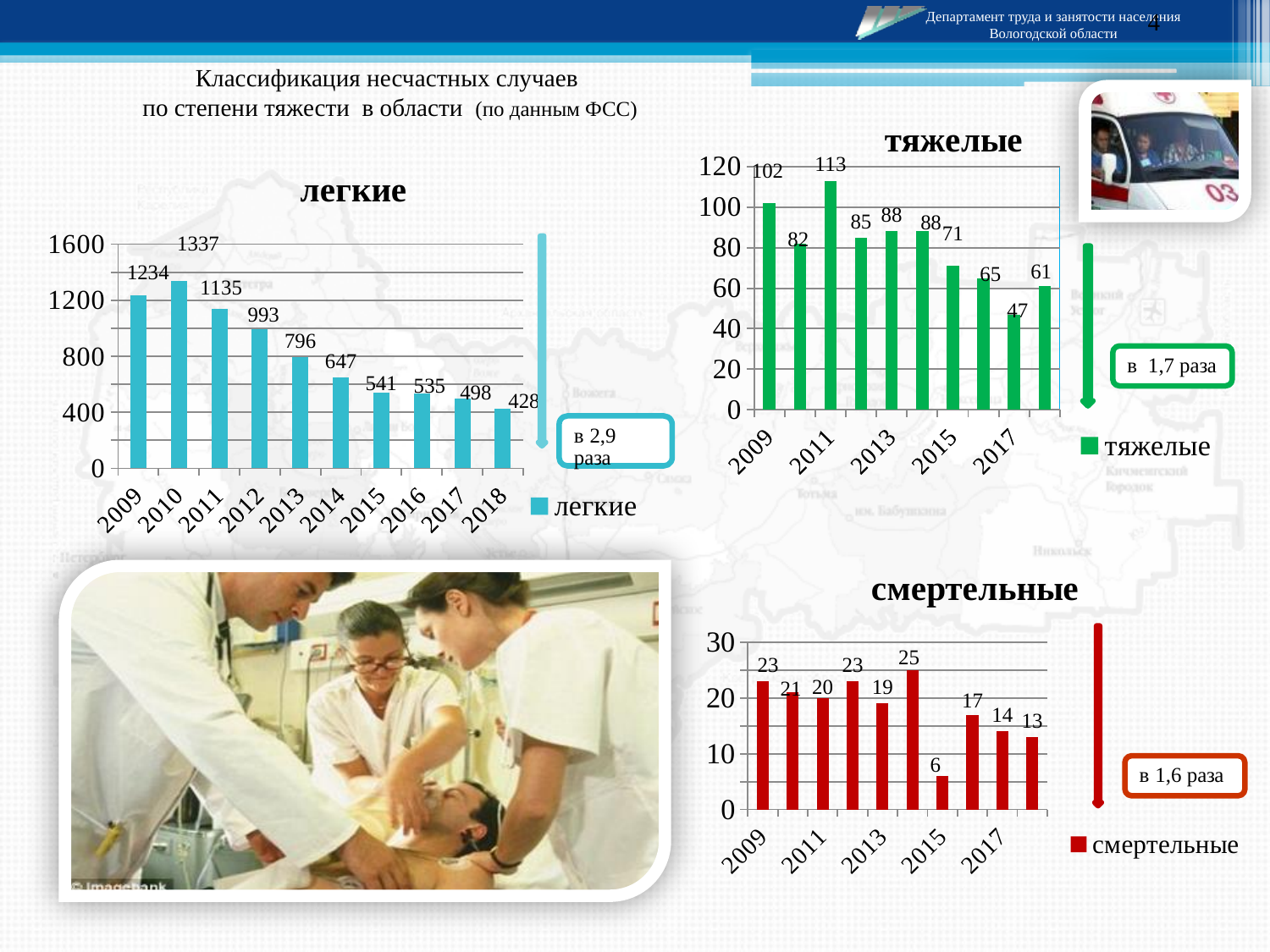
In the "легкие" chart, which year has the highest value? 2010 In the "легкие" chart, do the values generally rise or fall from 2010 to 2018? fall In the "легкие" chart, what is the value for 2018? 428 In the "тяжелые" chart, what is the value for 2017? 47 In the "легкие" chart, how many bars are plotted? 10 In the "тяжелые" chart, which year has the lowest value? 2017 In the "смертельные" chart, what is the value for 2015? 6 In the "легкие" chart, what is the value for 2010? 1337 In the "легкие" chart, what is the difference between the values for 2009 and 2018? 806 In the "смертельные" chart, which is larger, the value for 2009 or the value for 2013? 2009 In the "тяжелые" chart, what is the value for 2011? 113 What kind of chart is the "смертельные" chart? bar chart